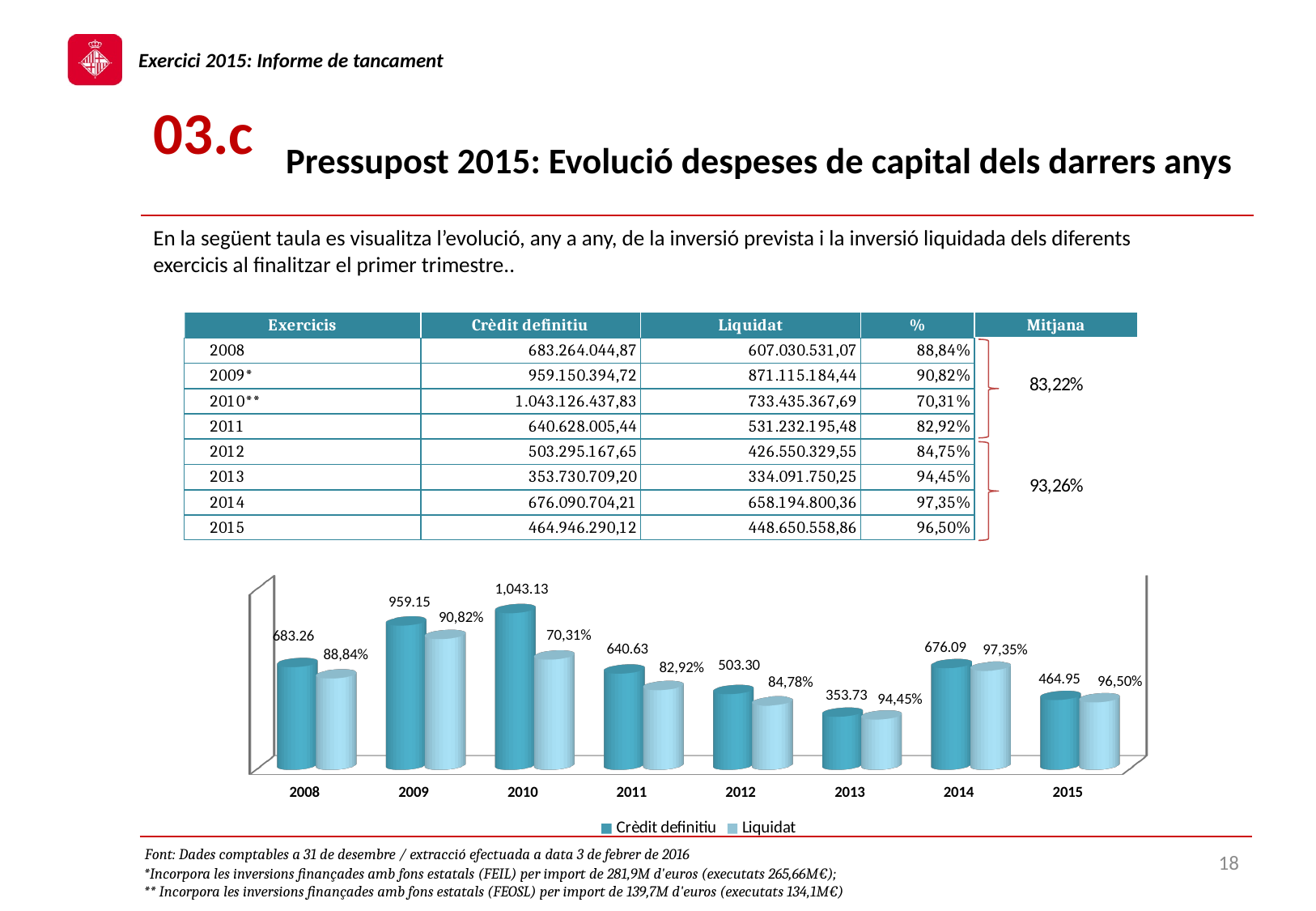
How many years are shown on the x axis of the chart? 8 What is the Crèdit definitiu value labelled for 2013 in the chart? 353.73 What are the two series named in the chart legend? Crèdit definitiu and Liquidat What is the difference between the Crèdit definitiu labels for 2010 and 2011 in the chart? 402.50 What percentage is labelled above the Liquidat bar for 2010 in the chart? 70,31% How many series does the chart legend list? 2 What is the Crèdit definitiu value labelled for 2010 in the chart? 1,043.13 Which year has the highest Crèdit definitiu bar in the chart? 2010 In the chart, is the Crèdit definitiu bar for 2009 taller than the one for 2014? Yes What kind of chart is shown on the slide? bar chart What percentage is labelled above the Liquidat bar for 2014 in the chart? 97,35% Which year has the lowest Crèdit definitiu bar in the chart? 2013